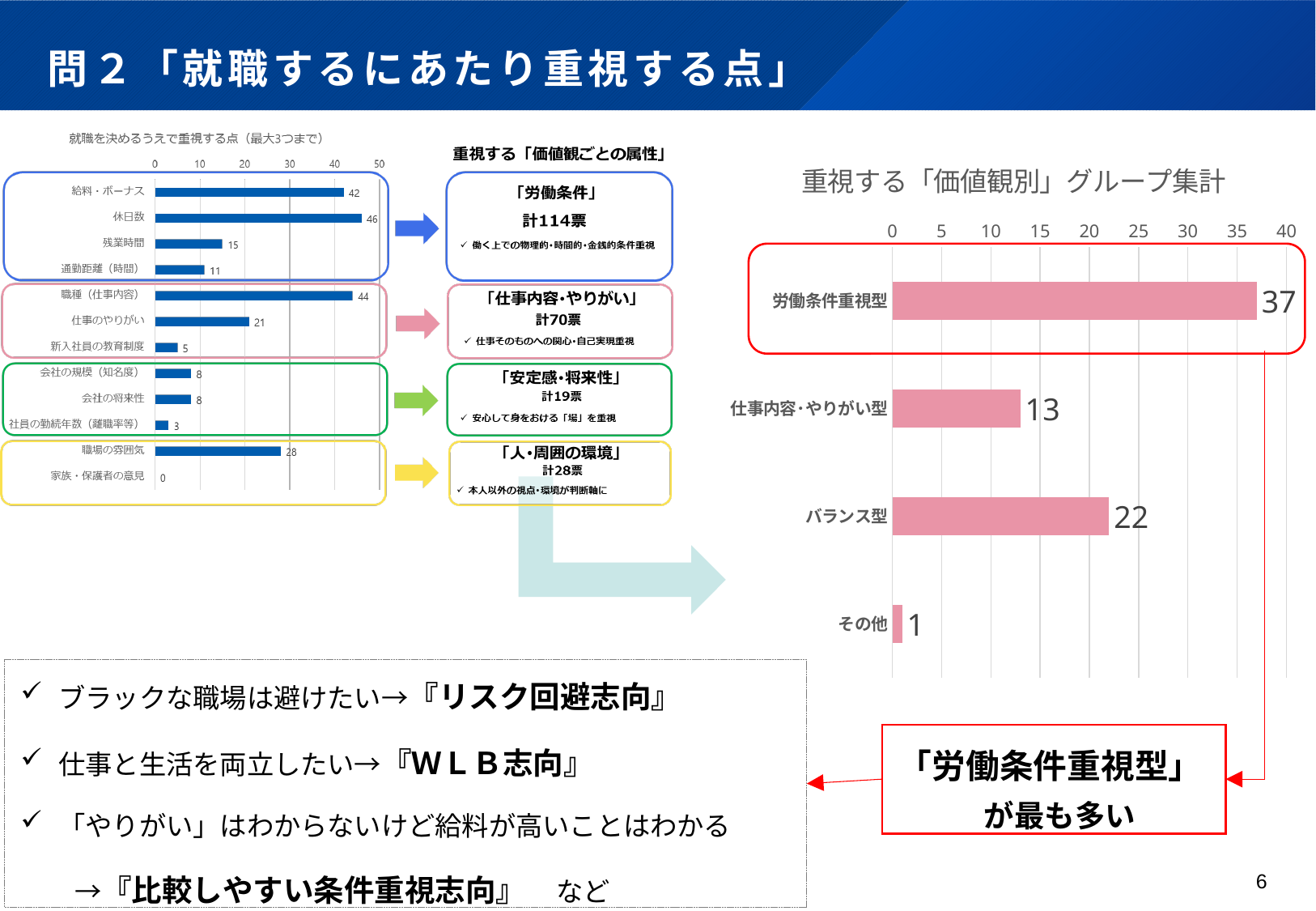
In the chart titled 就職を決めるうえで重視する点（最大3つまで）, what is the value for 家族・保護者の意見? 0 In the chart titled 重視する「価値観別」グループ集計, what kind of chart is it? bar chart In the chart titled 就職を決めるうえで重視する点（最大3つまで）, how many categories are plotted? 12 In the chart titled 就職を決めるうえで重視する点（最大3つまで）, which is larger, 給料・ボーナス or 職種（仕事内容）? 職種（仕事内容） In the chart titled 重視する「価値観別」グループ集計, how many categories are plotted? 4 In the chart titled 就職を決めるうえで重視する点（最大3つまで）, what is the value for 休日数? 46 In the chart titled 重視する「価値観別」グループ集計, which category has the lowest value? その他 In the chart titled 重視する「価値観別」グループ集計, what is the value for 労働条件重視型? 37 In the chart titled 重視する「価値観別」グループ集計, what is the difference between バランス型 and 仕事内容・やりがい型? 9 In the chart titled 就職を決めるうえで重視する点（最大3つまで）, what is the difference between 仕事のやりがい and 残業時間? 6 In the chart titled 就職を決めるうえで重視する点（最大3つまで）, what is the value for 職場の雰囲気? 28 In the chart titled 就職を決めるうえで重視する点（最大3つまで）, which category has the highest value? 休日数